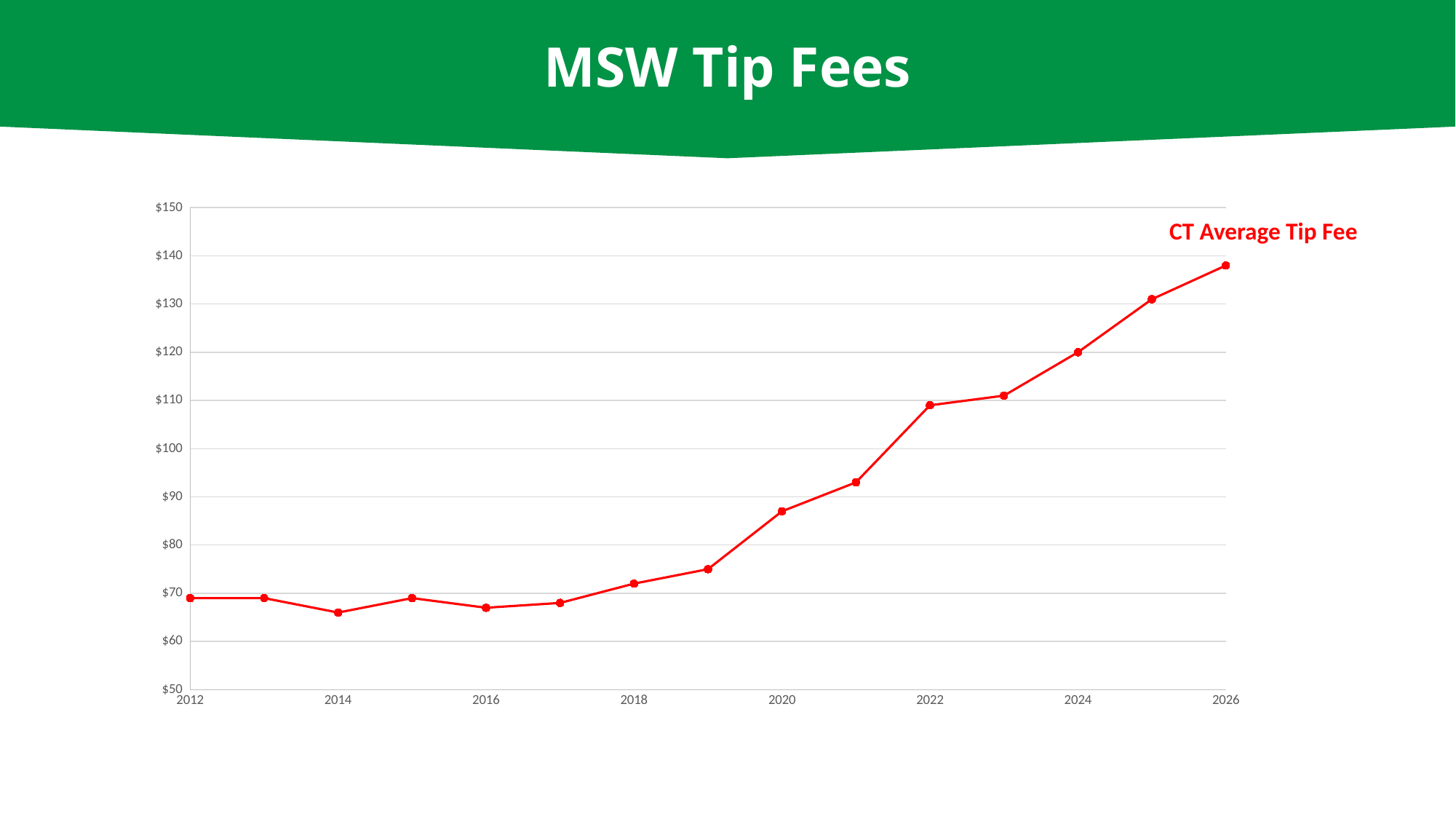
Is the CT Average Tip Fee for 2026 greater or less than $130? greater What is the title of the slide's chart? MSW Tip Fees What kind of chart is shown on the slide? line chart Which year has the highest CT Average Tip Fee? 2026 Overall, does the CT Average Tip Fee rise or fall from 2012 to 2026? rise Is the CT Average Tip Fee for 2022 greater or less than $100? greater Which year has a higher CT Average Tip Fee, 2019 or 2021? 2021 Which year has the lowest CT Average Tip Fee? 2014 How many data points are plotted on the line? 15 What is the name of the series plotted on the chart? CT Average Tip Fee Is the CT Average Tip Fee for 2020 greater or less than $90? less